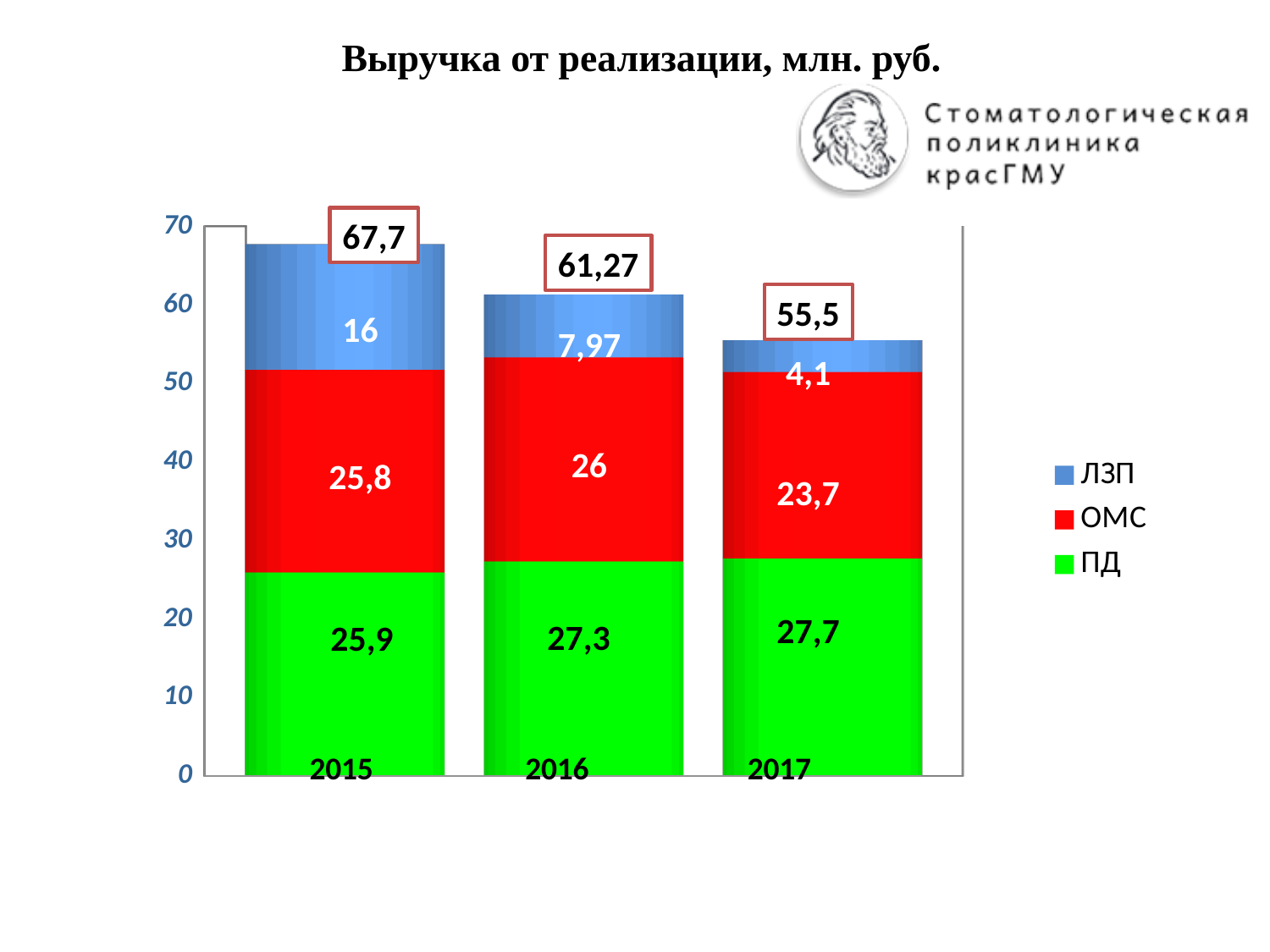
Is the total for 2017 greater or less than 60? less What is the ЛЗП value for 2015? 16 What is the ОМС value for 2017? 23,7 What is the ПД value for 2016? 27,3 Do the total revenue values rise or fall from 2015 to 2017? fall What is the total revenue shown for the 2016 bar? 61,27 How many years are shown on the x axis? 3 What is the difference between the ЛЗП values for 2015 and 2017? 11,9 Which year has the highest total revenue? 2015 Which is larger, the ОМС value for 2016 or the ОМС value for 2017? 2016 Which year has the lowest ЛЗП value? 2017 How many series does the legend list? 3